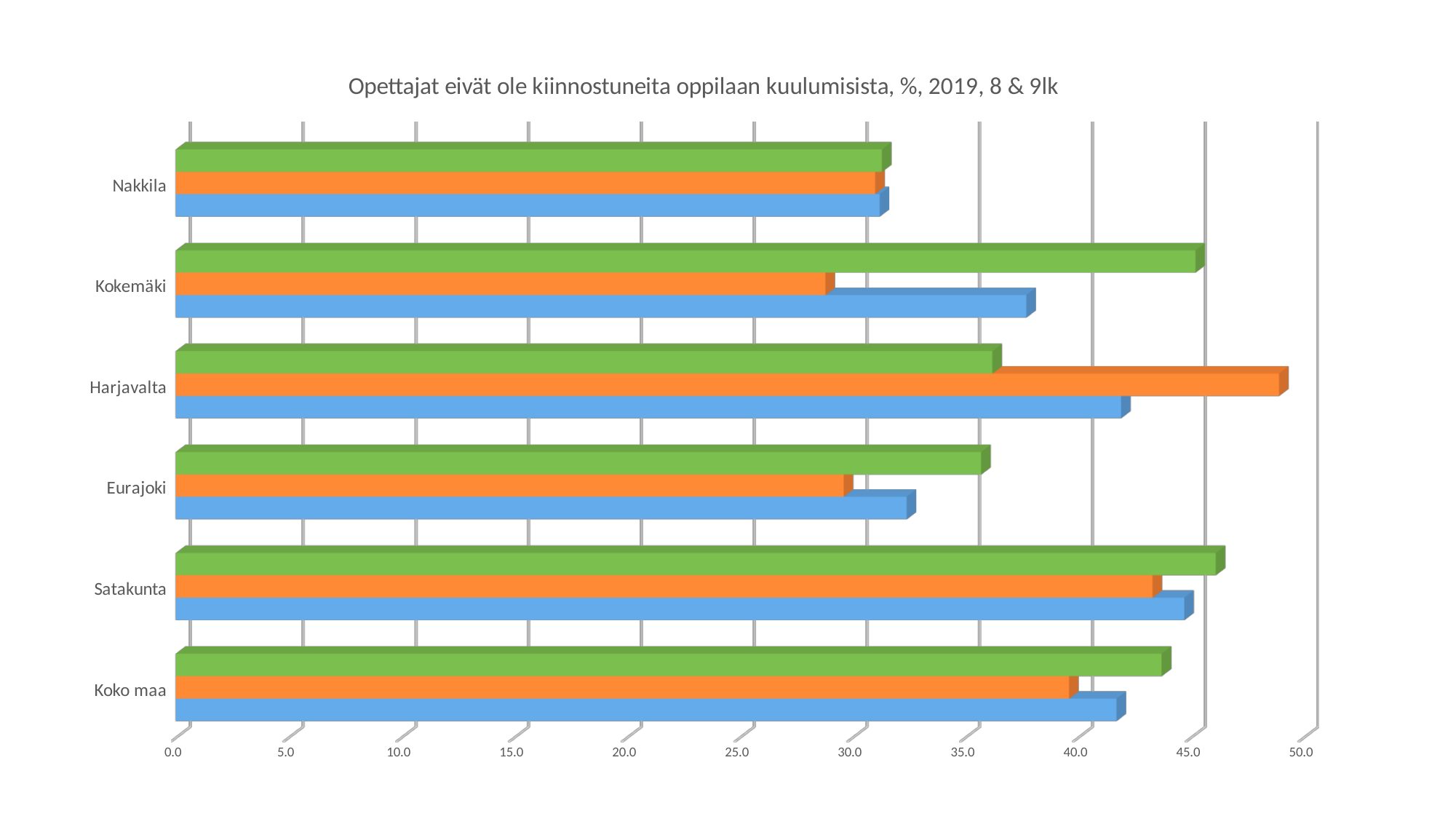
Is the value of the orange bar for Harjavalta greater or less than 45.0? greater What kind of chart is shown on the slide? bar chart Is the value of the blue bar for Kokemäki greater or less than 40.0? less Is the value of the blue bar for Koko maa greater or less than 40.0? greater What is the title of the chart? Opettajat eivät ole kiinnostuneita oppilaan kuulumisista, %, 2019, 8 & 9lk Which category has the longest orange bar? Harjavalta Which category has the shortest green bar? Nakkila For Kokemäki, which is larger: the green bar or the orange bar? the green bar How many bars are plotted for each category in the chart? 3 How many categories are shown on the vertical axis of the chart? 6